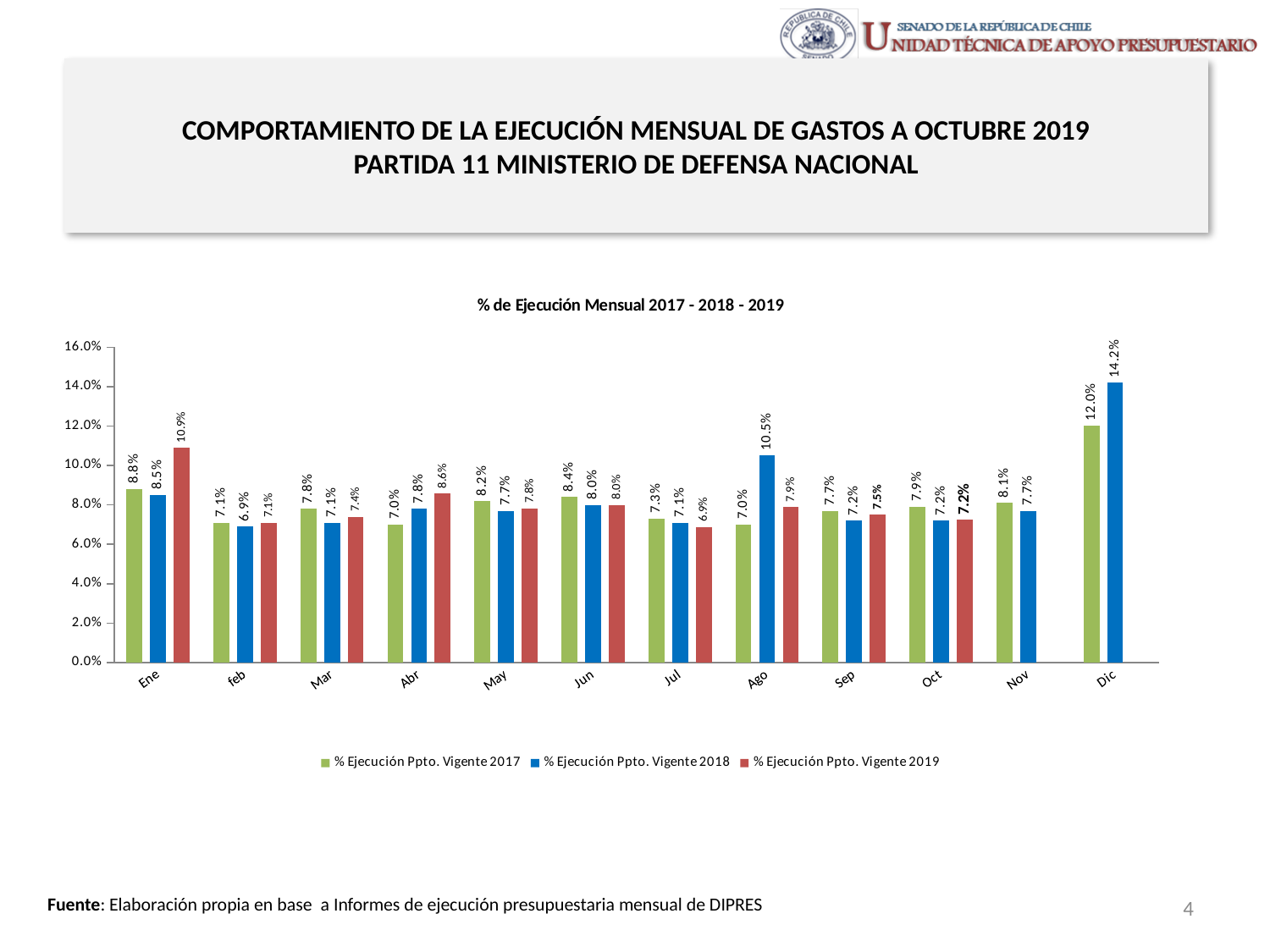
What is the value of % Ejecución Ppto. Vigente 2017 for Dic? 12.0% Is the value of % Ejecución Ppto. Vigente 2018 for Dic greater or less than 14.0%? greater What kind of chart is shown on the slide? Bar chart Which month has the lowest value for % Ejecución Ppto. Vigente 2019? Jul Which is larger for Abr: the 2017 value or the 2019 value? 2019 value (8.6%) What is the title of the chart? % de Ejecución Mensual 2017 - 2018 - 2019 What is the difference between the 2018 and 2017 values for Dic? 2.2% What is the value of % Ejecución Ppto. Vigente 2019 for Ene? 10.9% Which month has the highest value for % Ejecución Ppto. Vigente 2018? Dic How many months are shown on the x axis? 12 How many series does the legend list? 3 What is the value of % Ejecución Ppto. Vigente 2018 for Ago? 10.5%